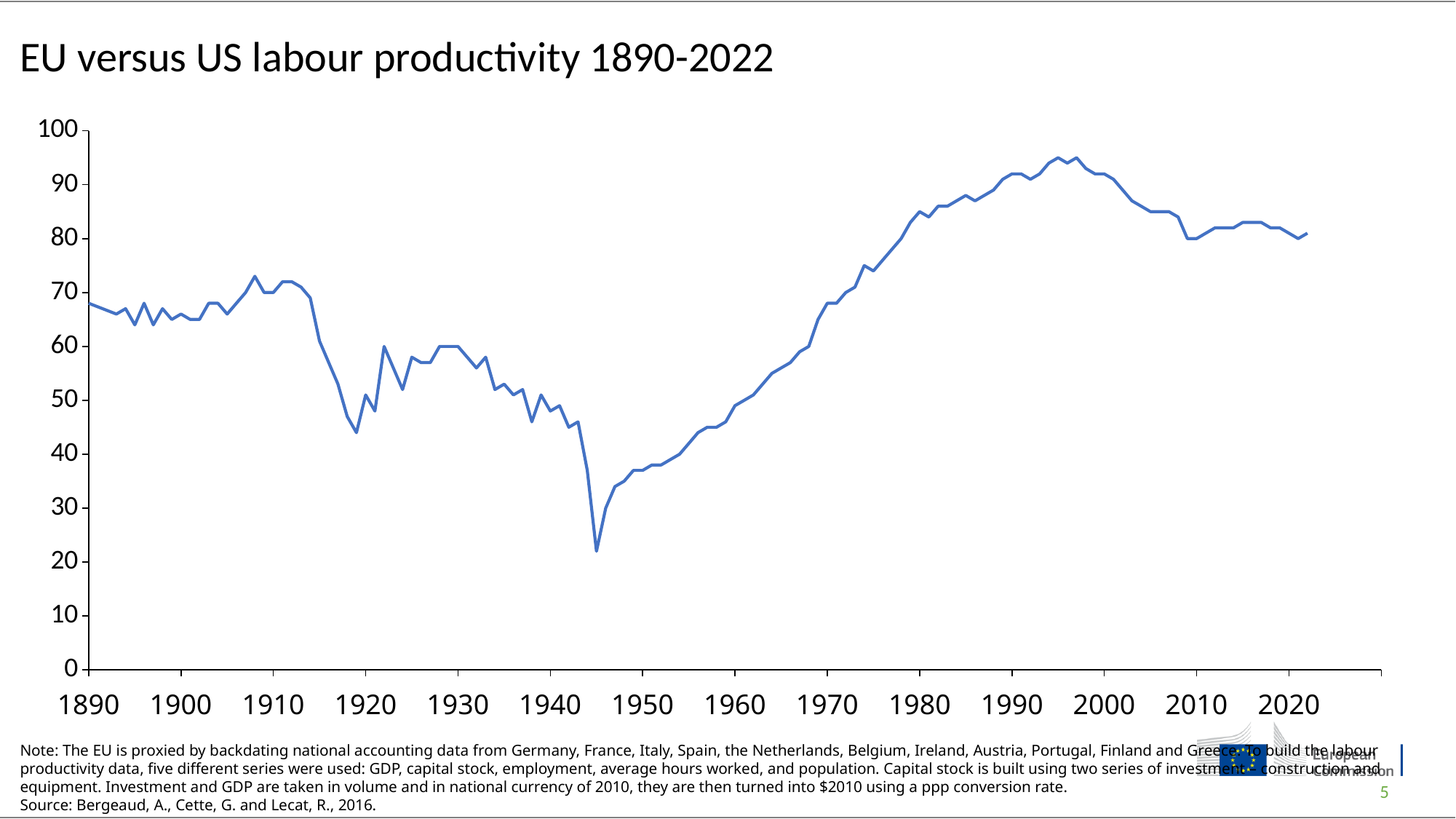
Is the value for 1950 greater or less than 40? less Is the value for 1970 greater or less than 60? greater In which decade does the line reach its lowest point? 1940s Is the value for 1890 greater or less than 60? greater What is the title of the chart? EU versus US labour productivity 1890-2022 Which is larger, the value for 1890 or the value for 1950? 1890 Does the line rise or fall between 2000 and 2010? fall Does the line rise or fall between 1950 and 1990? rise What kind of chart is shown on the slide? line chart In which decade does the line reach its highest point? 1990s